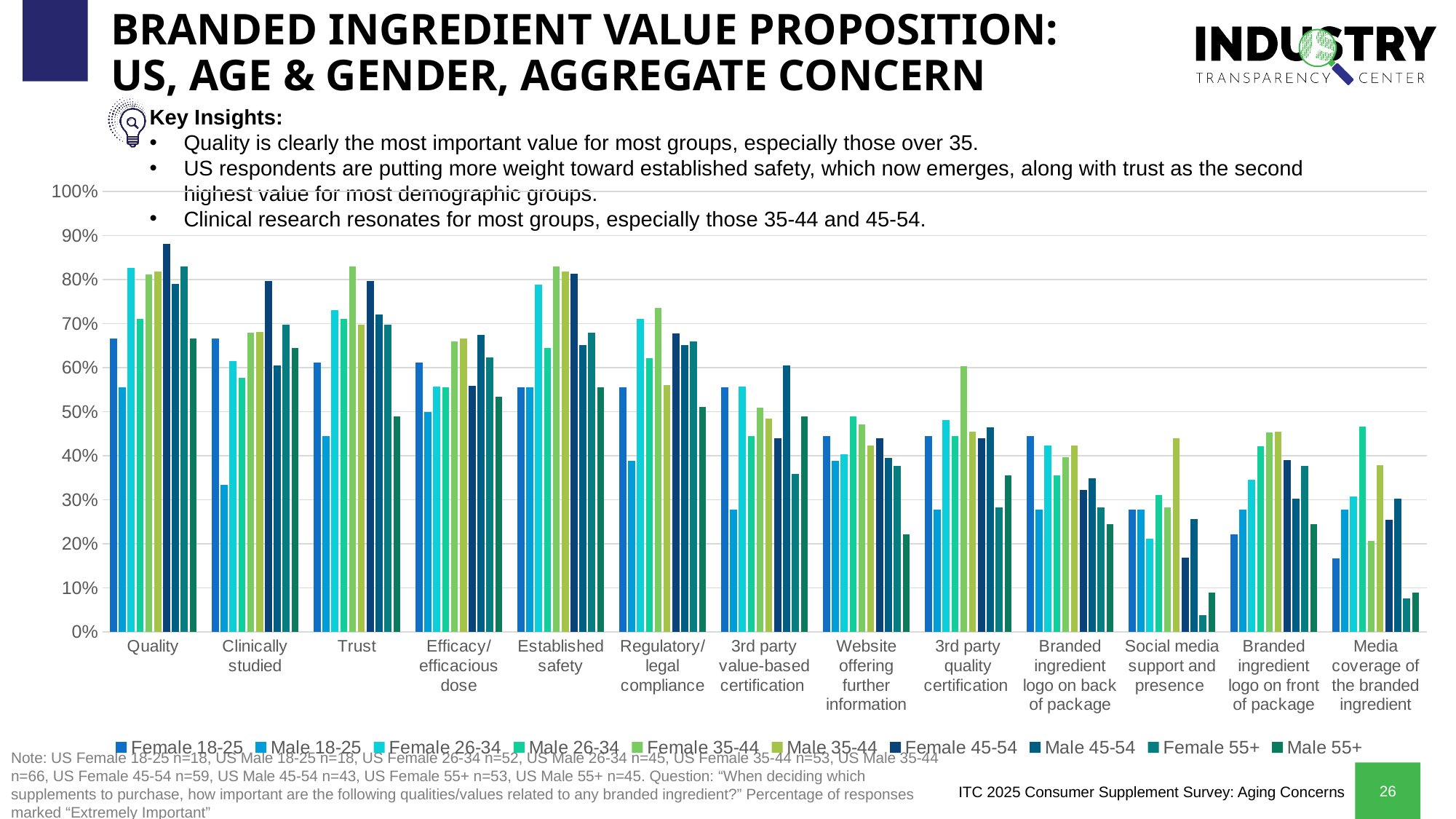
How many categories are shown along the x axis of the chart? 13 Is the value for Female 35-44 in the 3rd party quality certification category greater or less than 50%? greater For Male 18-25, is the value larger for Quality or for Clinically studied? Quality Which category contains the lowest bar on the chart? Social media support and presence What type of chart is shown on the slide? Bar chart Is the value for Female 45-54 in the Quality category greater or less than 80%? greater Is the value for Male 55+ in the Media coverage of the branded ingredient category greater or less than 20%? less Within the Quality category, which series has the highest bar? Female 45-54 Do the bar heights generally rise or fall moving from left to right across the categories? fall How many series does the chart's legend list? 10